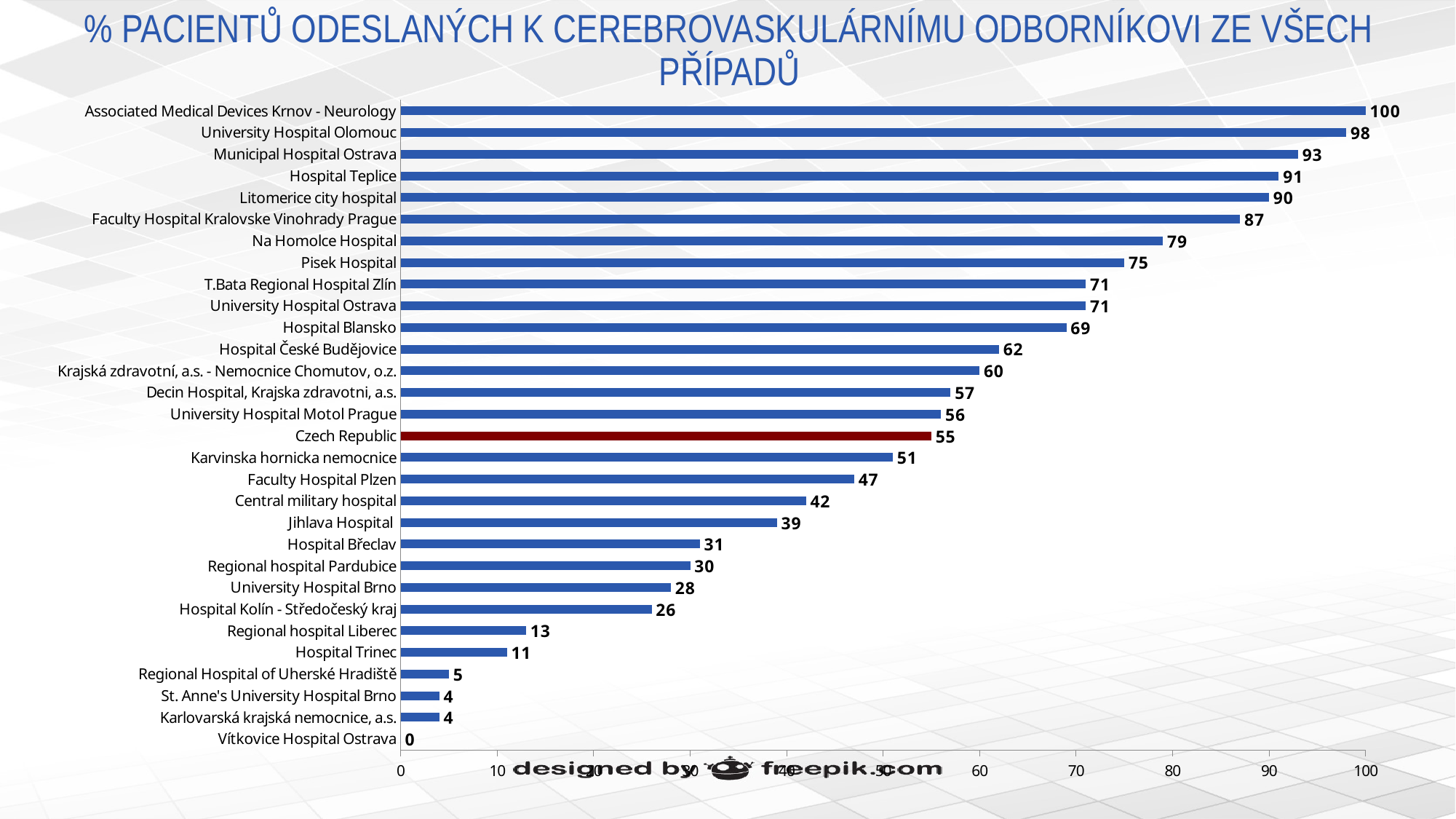
What is the value for Hospital Trinec? 11 What is the value for University Hospital Motol Prague? 56 Which is larger, the value for Pisek Hospital or the value for Na Homolce Hospital? Na Homolce Hospital Which bar is shown in a different colour (dark red) from the others? Czech Republic Which category has the lowest value? Vítkovice Hospital Ostrava How many categories are shown on the chart? 30 Which category has the highest value? Associated Medical Devices Krnov - Neurology Is the value for Faculty Hospital Plzen greater or less than 50? less What is the difference between the values for University Hospital Olomouc and Municipal Hospital Ostrava? 5 What kind of chart is shown on the slide? bar chart What is the value for Regional hospital Liberec? 13 What is the value for Czech Republic? 55